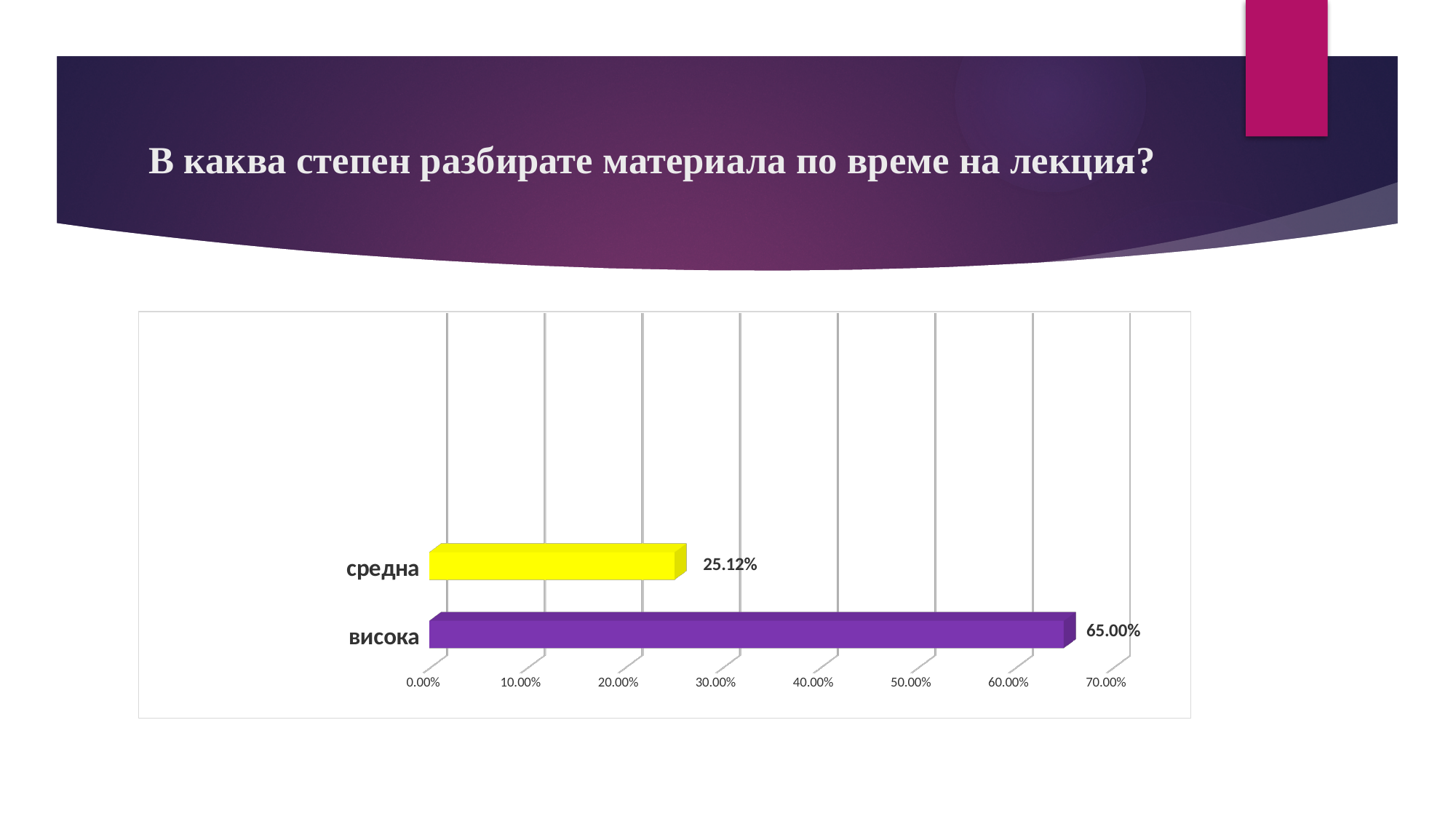
Is the value for висока greater or less than 60.00%? greater How many categories are shown in the chart? 2 Which category has the highest value? висока What is the difference between the values for висока and средна? 39.88% Which is larger, the value for средна or the value for висока? висока What is the value for висока? 65.00% What is the value for средна? 25.12% What colour is the bar for средна? yellow Which category has the lowest value? средна Is the value for средна greater or less than 30.00%? less What is the title of the slide? В каква степен разбирате материала по време на лекция? What kind of chart is shown on the slide? bar chart